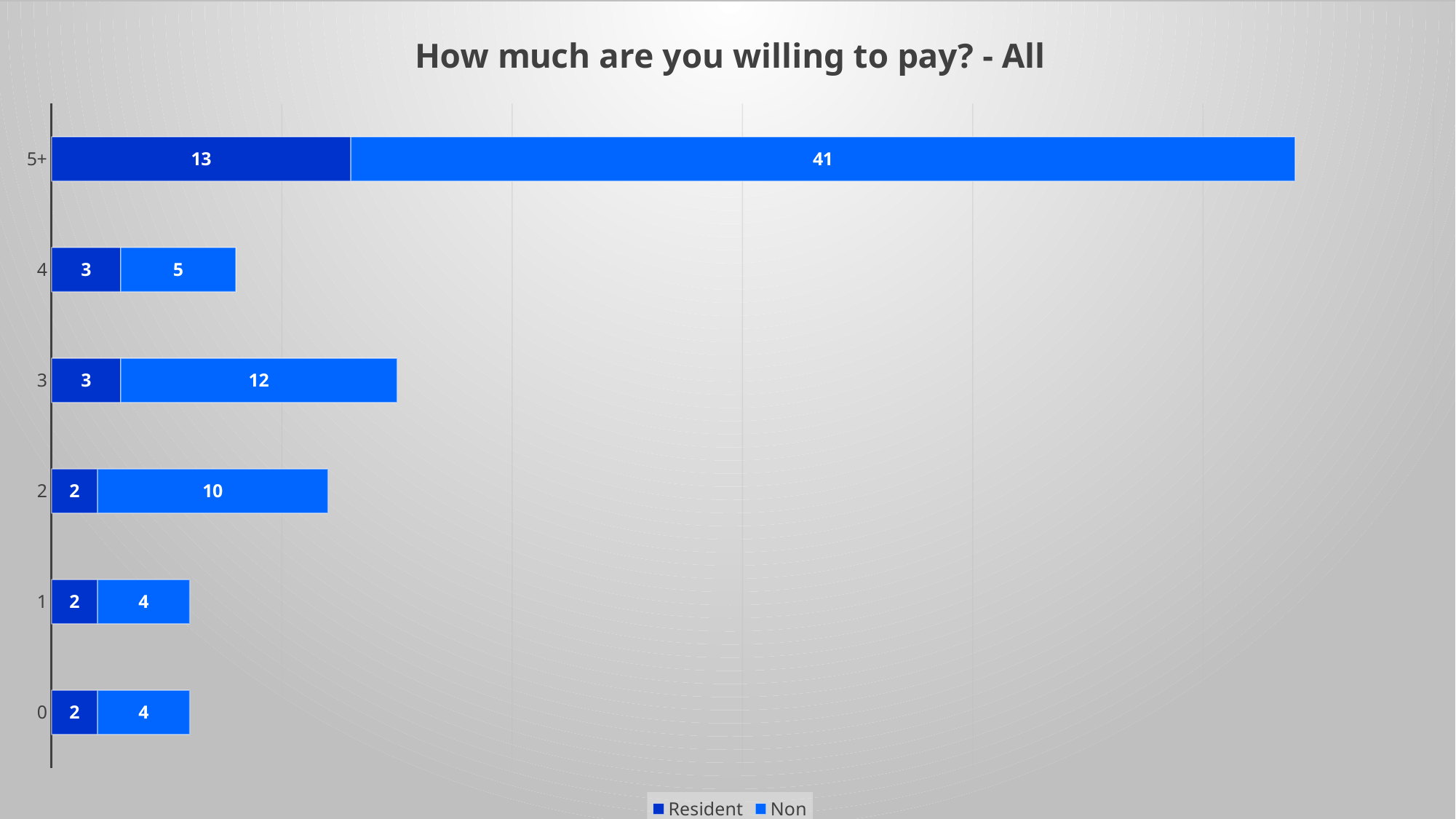
What is the title of the chart? How much are you willing to pay? - All What kind of chart is shown on the slide? Stacked bar chart What is the Non value for the 2 category? 10 What is the total of the stacked bar for the 5+ category? 54 How many categories are shown on the y axis? 6 Which category has the highest Resident value? 5+ What is the Non value for the 3 category? 12 What is the Resident value for the 5+ category? 13 What is the difference between the Non and Resident values for the 5+ category? 28 Is the Non value for category 3 larger than the Non value for category 4? Yes, 12 is larger than 5 How many series does the legend list? 2 Which category has the highest Non value? 5+